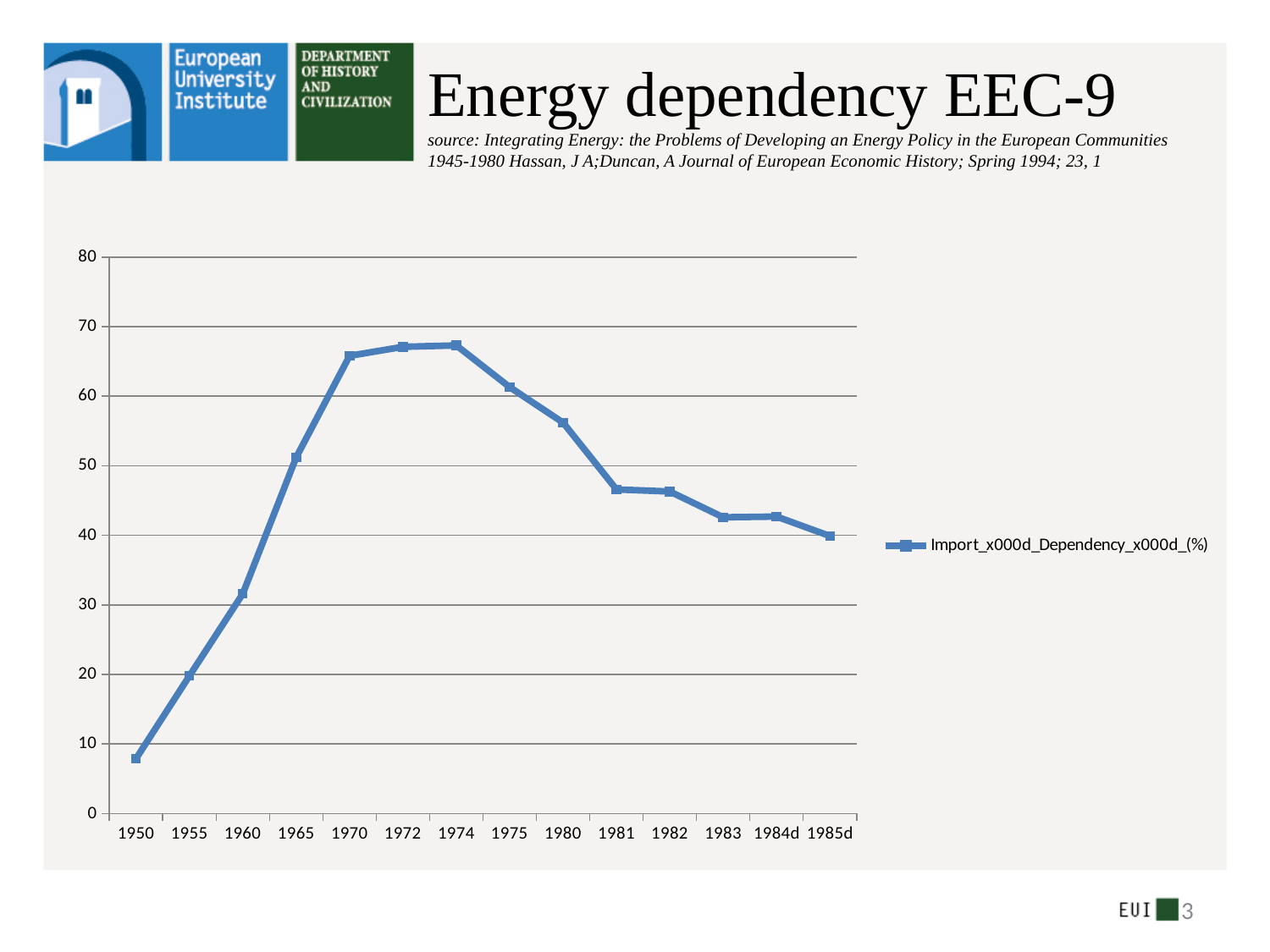
Is the value for 1980 greater or less than 50? greater Which is larger, the value for 1980 or the value for 1985d? 1980 Is the value for 1985d greater or less than 50? less Is the value for 1970 greater or less than 60? greater Do the values rise or fall from 1950 to 1970? rise How many data points are plotted on the line? 14 Which year has the lowest import dependency value? 1950 Which is larger, the value for 1950 or the value for 1970? 1970 What is the title of the chart on the slide? Energy dependency EEC-9 What kind of chart is shown on the slide? line chart How many series does the legend list? 1